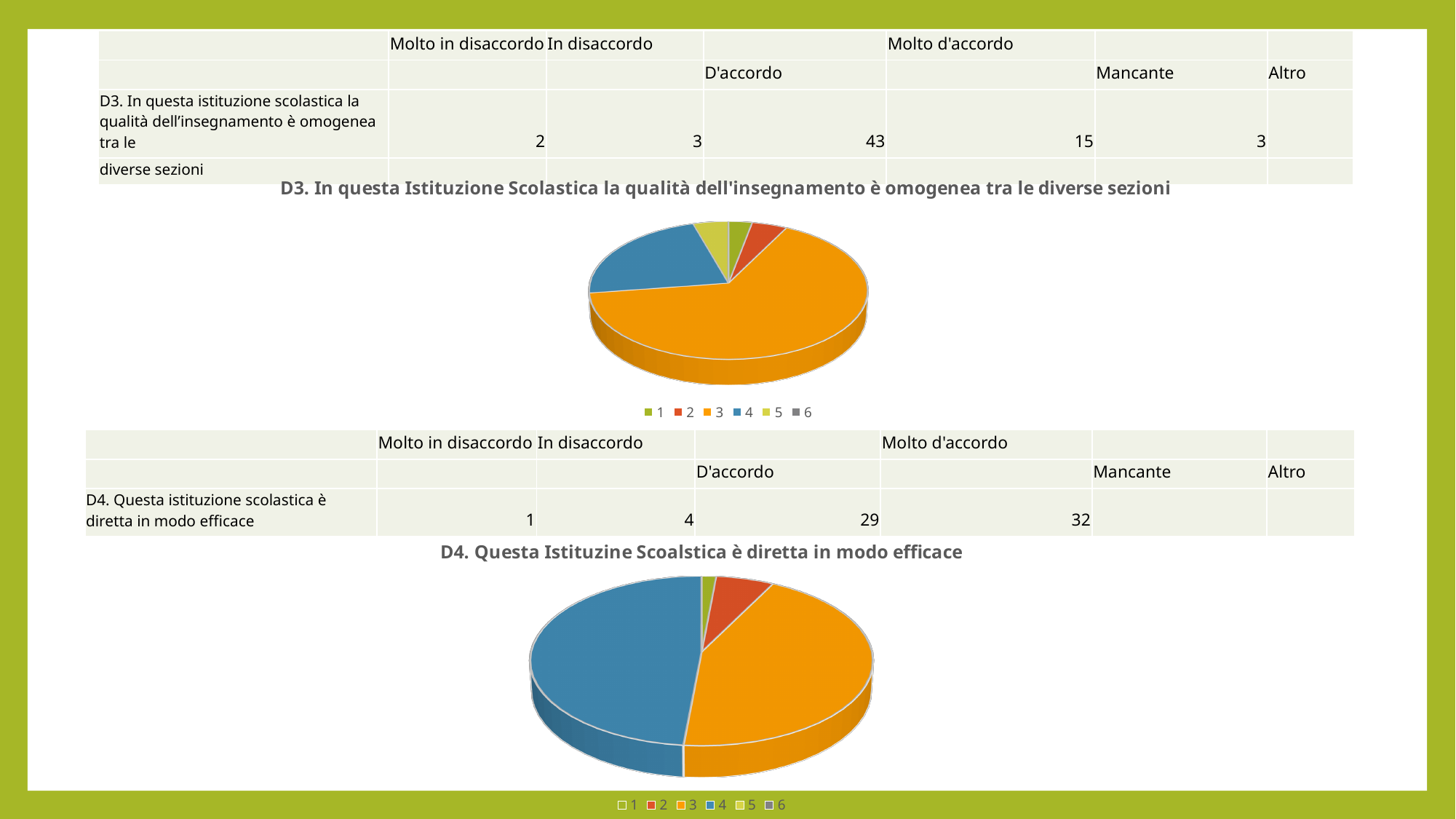
According to the table above the D3 chart, how many respondents answered 'D'accordo' to D3? 43 What is the title of the lower pie chart on the slide? D4. Questa Istituzine Scoalstica è diretta in modo efficace For D3, what is the difference between the 'D'accordo' and 'Mancante' counts in the table? 40 For D4, what is the difference between the 'Molto d'accordo' and 'D'accordo' counts in the table? 3 How many entries does the legend of the D3 pie chart list? 6 In the D3 pie chart, which legend entry corresponds to the largest slice? 3 According to the table above the D3 chart, how many responses to D3 are 'Mancante'? 3 What kind of chart is shown under the title 'D3. In questa Istituzione Scolastica la qualità dell'insegnamento è omogenea tra le diverse sezioni'? Pie chart According to the table above the D4 chart, how many respondents answered 'Molto in disaccordo' to D4? 1 In the D4 pie chart, which legend entry corresponds to the smallest slice? 1 According to the table above the D4 chart, how many respondents answered 'Molto d'accordo' to D4? 32 For D4, which has more responses according to the table: 'D'accordo' or 'Molto d'accordo'? Molto d'accordo